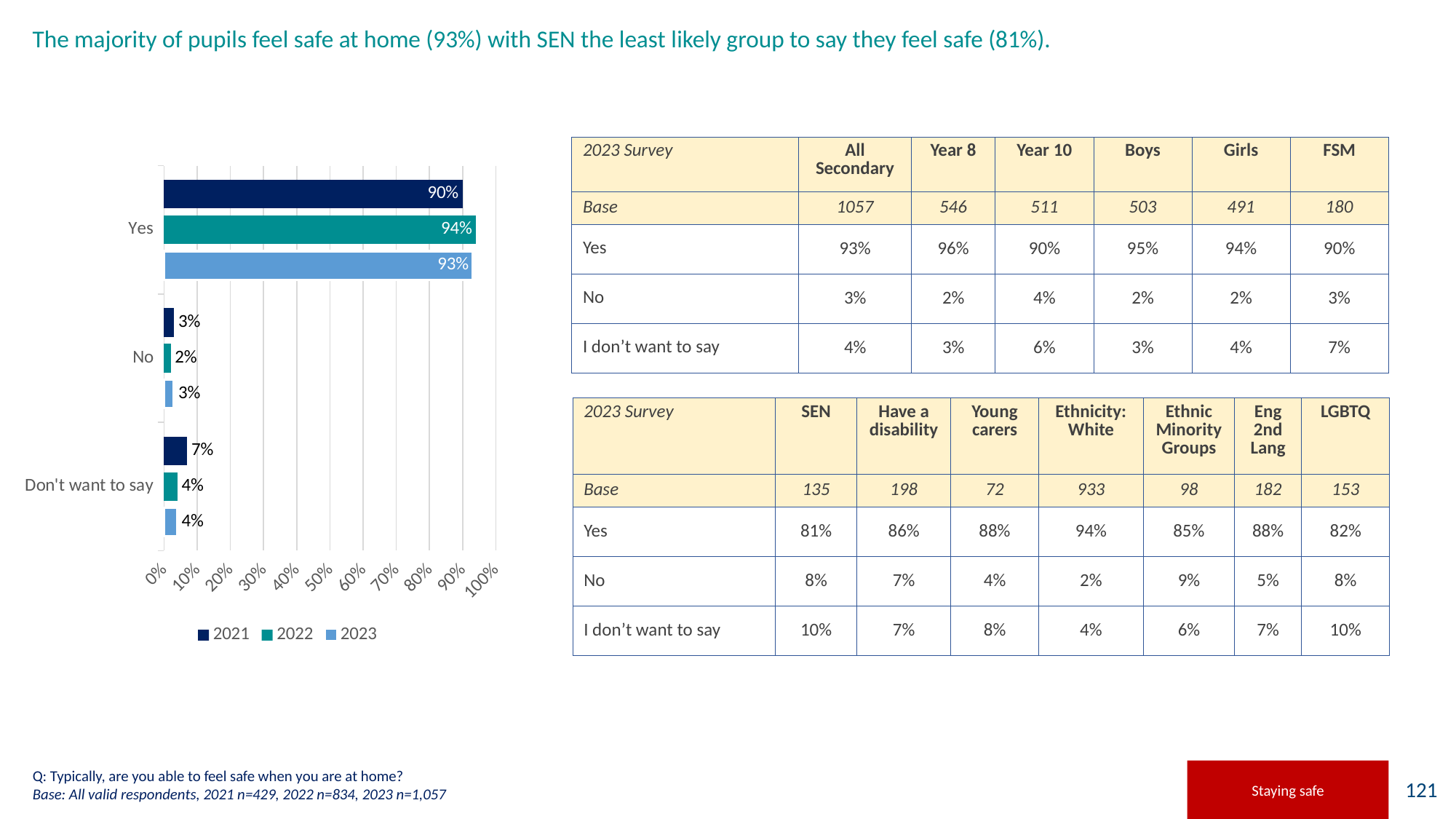
How many response categories are shown on the bar chart? 3 How many series does the bar chart legend list? 3 What type of chart is shown on the slide? Bar chart What is the difference between the 'Yes' values for 2022 and 2021 in the bar chart? 4% Which year had the lowest 'No' value in the bar chart? 2022 In the bar chart, is the 'Don't want to say' value larger for 2021 or 2023? 2021 Which years are listed in the bar chart legend? 2021, 2022, 2023 What percentage of pupils answered 'No' in 2023 according to the bar chart? 3% What percentage of pupils answered 'Yes' in 2022 according to the bar chart? 94% Which year had the highest 'Yes' value in the bar chart? 2022 Is the 2023 'Yes' value in the bar chart greater or less than 80%? greater What percentage of pupils answered 'Don't want to say' in 2021 according to the bar chart? 7%